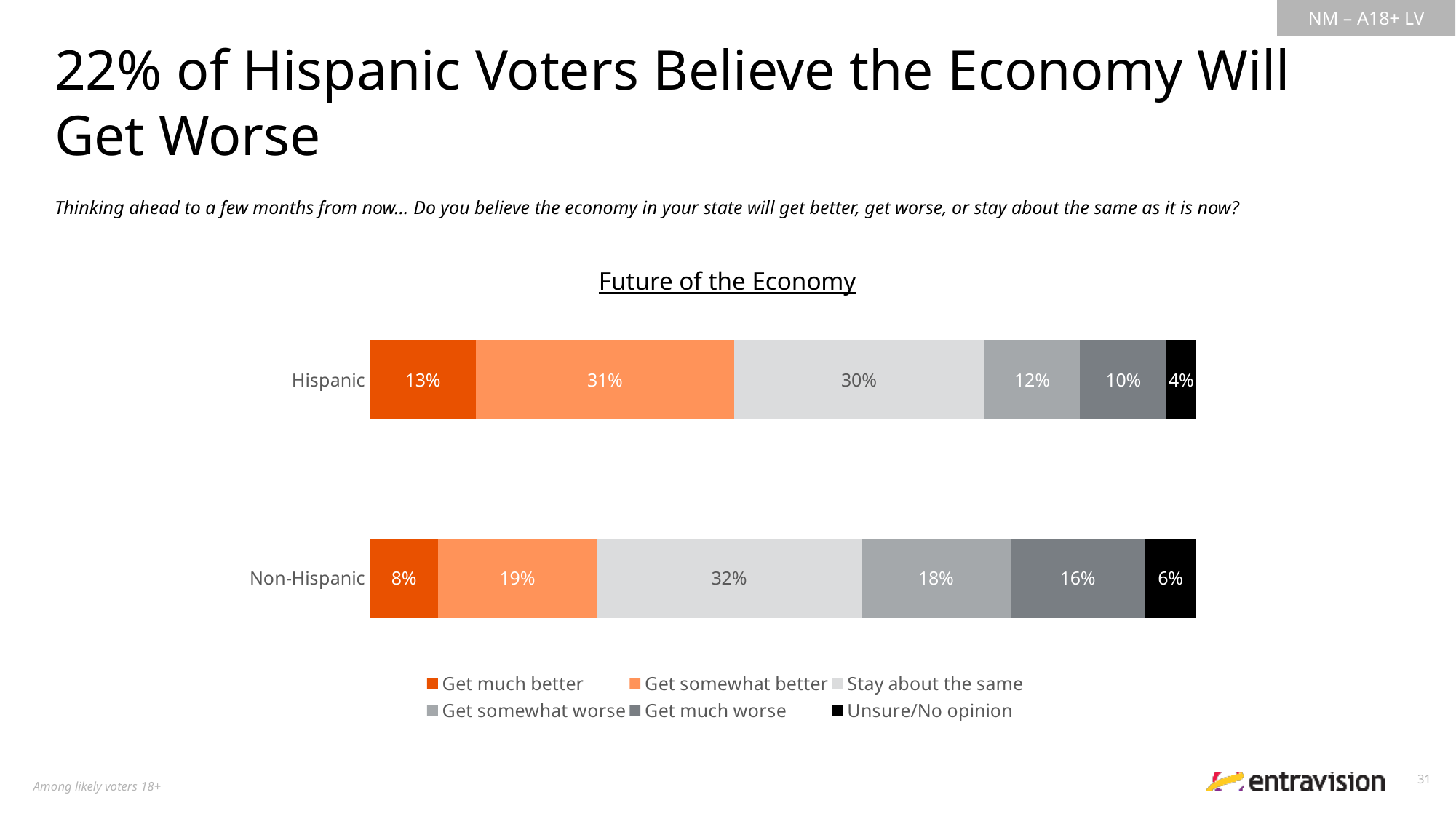
Which response category has the smallest share among Non-Hispanic voters? Unsure/No opinion What percentage of Hispanic voters are unsure or have no opinion? 4% What is the difference between the Non-Hispanic and Hispanic shares saying the economy will get somewhat worse? 6 percentage points Which response category has the largest share among Hispanic voters? Get somewhat better What is the title of the chart? Future of the Economy What type of chart is shown on the slide? Stacked bar chart What percentage of Non-Hispanic voters say the economy will stay about the same? 32% What is the difference between the Hispanic and Non-Hispanic shares saying the economy will get somewhat better? 12 percentage points What percentage of Non-Hispanic voters say the economy will get much worse? 16% How many series does the legend list? 6 What percentage of Hispanic voters say the economy will get somewhat better? 31% Which group has the higher share saying the economy will get much better, Hispanic or Non-Hispanic? Hispanic